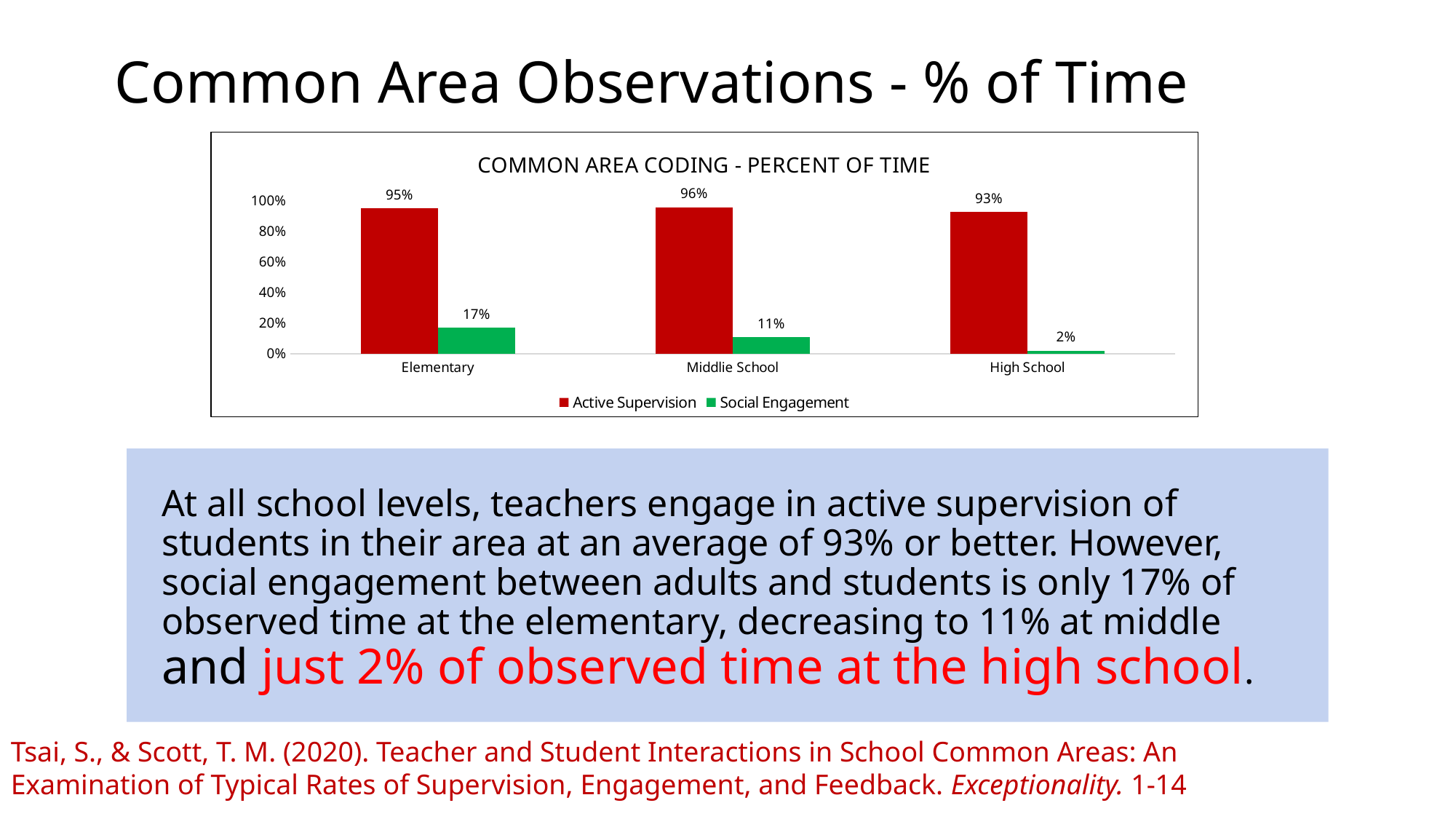
Which is larger, the Active Supervision value for Elementary or for High School? Elementary Which school level has the highest Active Supervision value? Middle School Do the Social Engagement values rise or fall from Elementary to High School? Fall How many series does the legend list? 2 What is the difference between Active Supervision and Social Engagement for Elementary? 78% What kind of chart is shown? Bar chart Which school level has the lowest Social Engagement value? High School What is the Social Engagement value for High School? 2% What is the difference in Social Engagement between Elementary and High School? 15% How many school levels are shown on the x axis? 3 What is the Social Engagement value for Middle School? 11% What is the Active Supervision value for Elementary? 95%